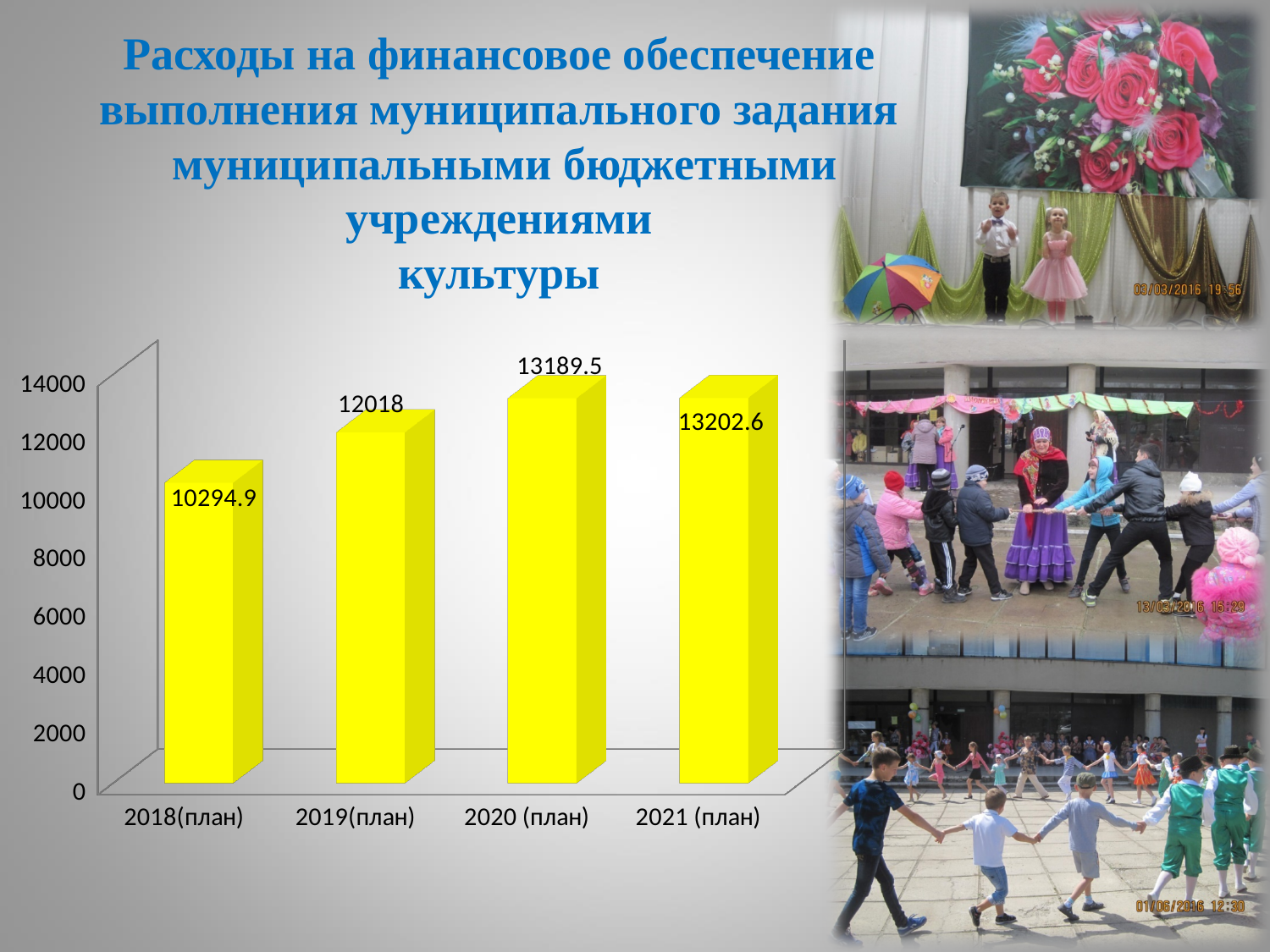
What is the value for 2018(план)? 10294.9 Do the values rise or fall from 2018(план) to 2021 (план)? rise Is the value for 2018(план) greater or less than 12000? less What is the difference between the values for 2020 (план) and 2019(план)? 1171.5 What is the value for 2021 (план)? 13202.6 Which category has the lowest value? 2018(план) What is the difference between the values for 2019(план) and 2018(план)? 1723.1 How many categories are shown on the x axis? 4 Which category has the highest value? 2021 (план) Which is larger, the value for 2019(план) or the value for 2020 (план)? 2020 (план) What is the value for 2020 (план)? 13189.5 What is the value for 2019(план)? 12018